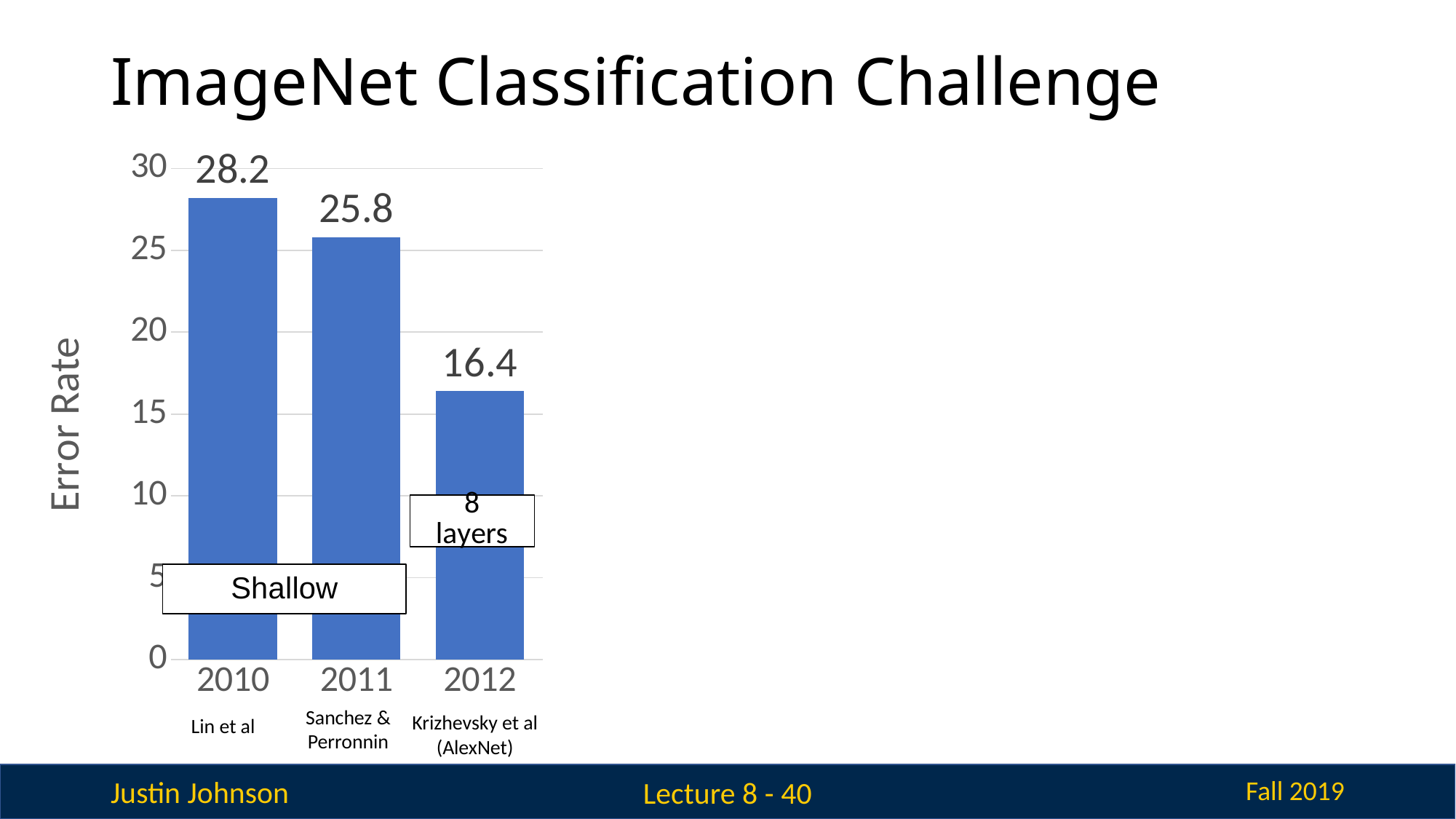
What is the difference in error rate between 2010 and 2012? 11.8 What is the error rate for 2011? 25.8 What kind of chart is shown on the slide? bar chart Which year has the highest error rate? 2010 What is the error rate for 2012? 16.4 Which year has the lowest error rate? 2012 Does the error rate rise or fall from 2010 to 2012? fall What is the difference in error rate between 2010 and 2011? 2.4 Which has a larger error rate, 2011 or 2012? 2011 What is the error rate for 2010? 28.2 Is the error rate for 2012 greater or less than 20? less How many years are shown on the x axis? 3